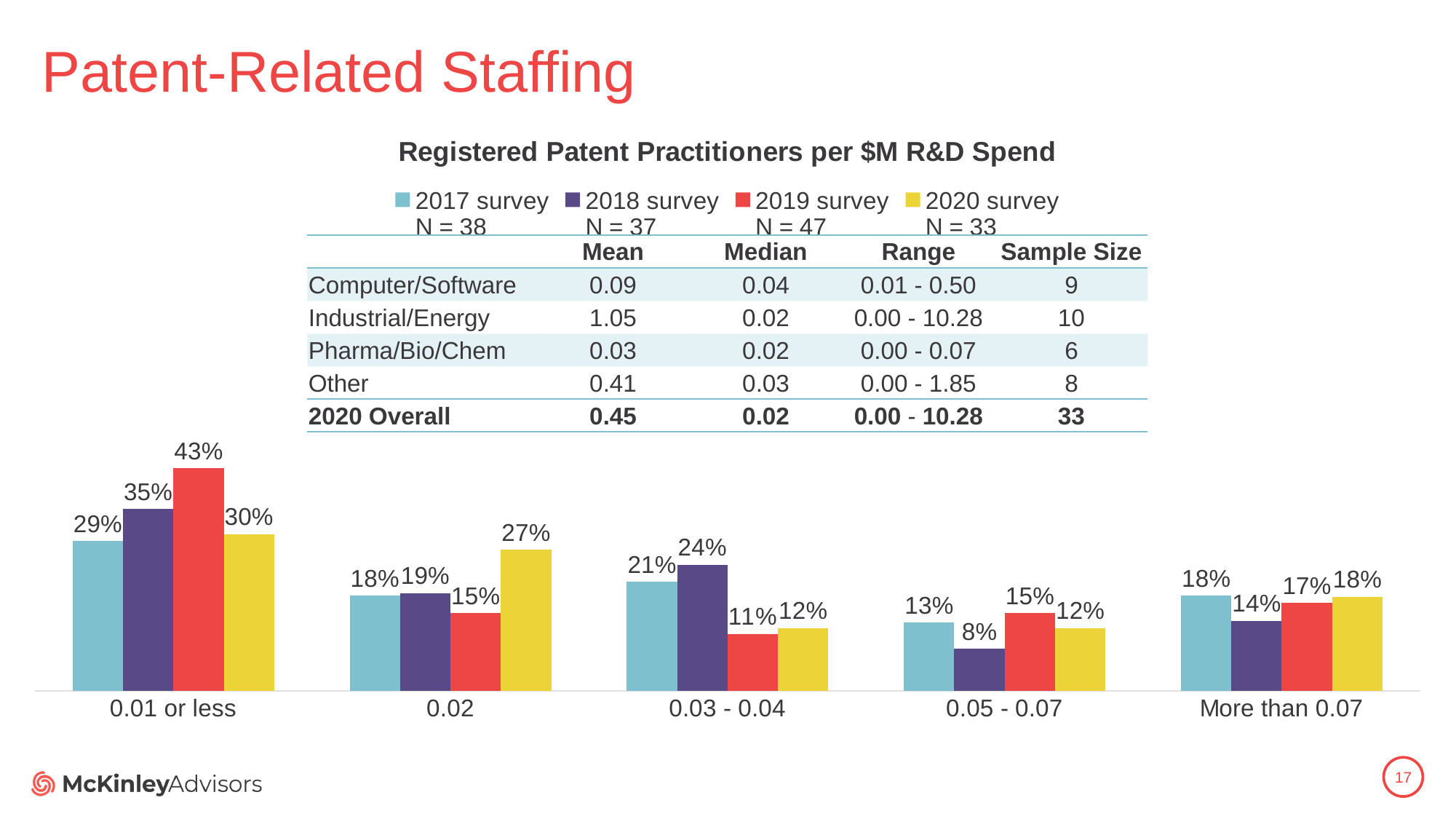
How many categories are shown on the x axis of the chart? 5 How many series does the chart legend list? 4 What is the sample size (N) for the 2019 survey shown in the legend? N = 47 What is the 2018 survey value for the "0.05 - 0.07" category? 8% For the "0.03 - 0.04" category, which is larger: the 2018 survey value or the 2020 survey value? 2018 survey What is the difference between the 2019 and 2017 survey values for "0.01 or less"? 14% Do the 2019 survey values rise or fall from "0.01 or less" to "0.03 - 0.04"? Fall What is the 2019 survey value for the "0.01 or less" category? 43% What kind of chart is shown on the slide? Bar chart Which category has the lowest 2019 survey value? 0.03 - 0.04 What is the 2020 survey value for the "0.02" category? 27% Which category has the highest 2017 survey value? 0.01 or less